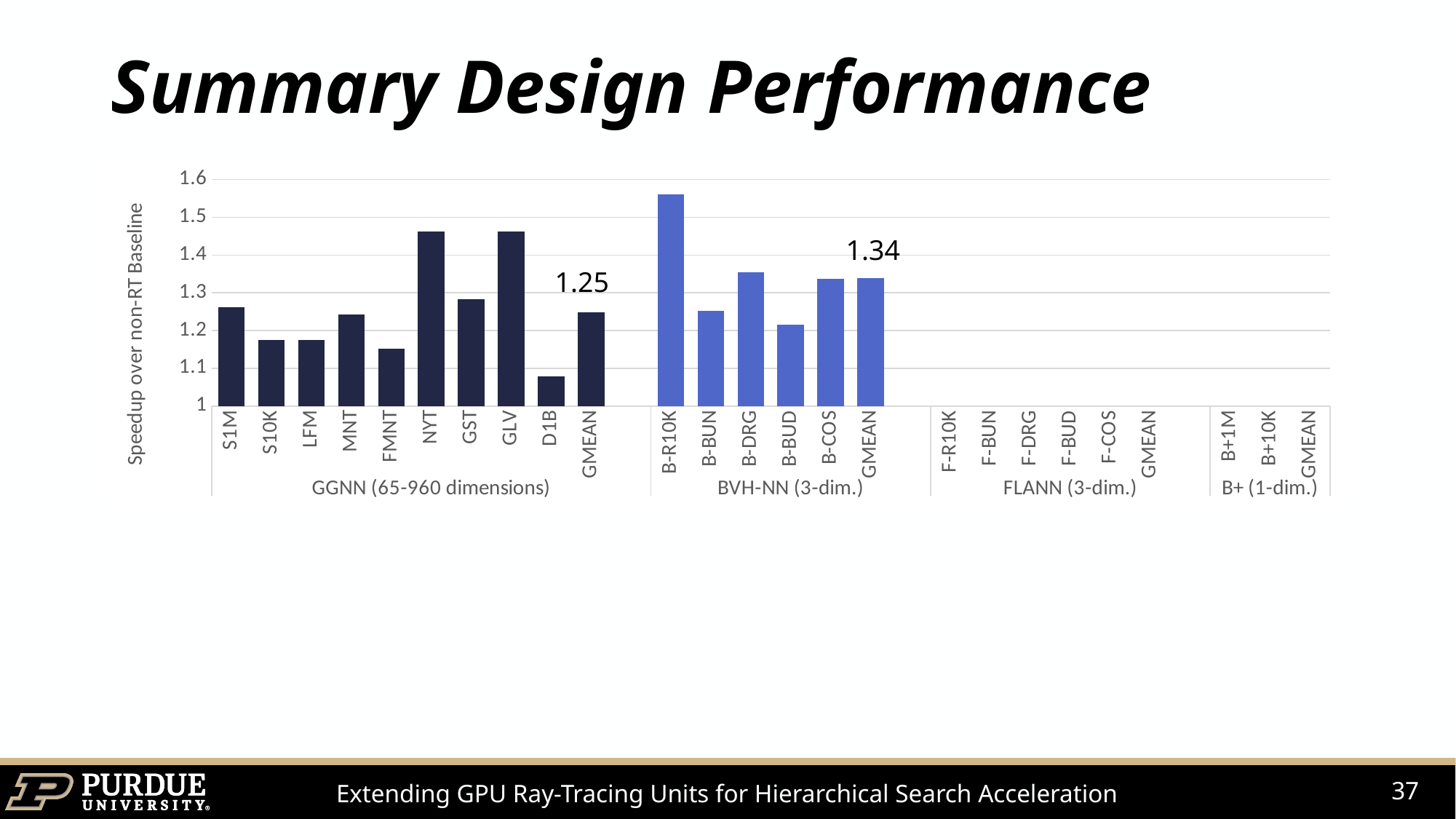
How many bars are plotted in the GGNN (65-960 dimensions) group, including GMEAN? 10 Which category has the shortest bar in the chart? D1B What is the difference between the BVH-NN GMEAN and the GGNN GMEAN? 0.09 Is the value for D1B greater or less than 1.1? less What kind of chart is shown on the slide? bar chart Is the value for FMNT greater or less than 1.2? less What is the label of the y axis? Speedup over non-RT Baseline Which is larger, the value for NYT or the value for GST? NYT What is the GMEAN speedup for the BVH-NN (3-dim.) group? 1.34 Which category has the tallest bar in the chart? B-R10K Is the value for B-R10K greater or less than 1.5? greater What is the GMEAN speedup for the GGNN (65-960 dimensions) group? 1.25